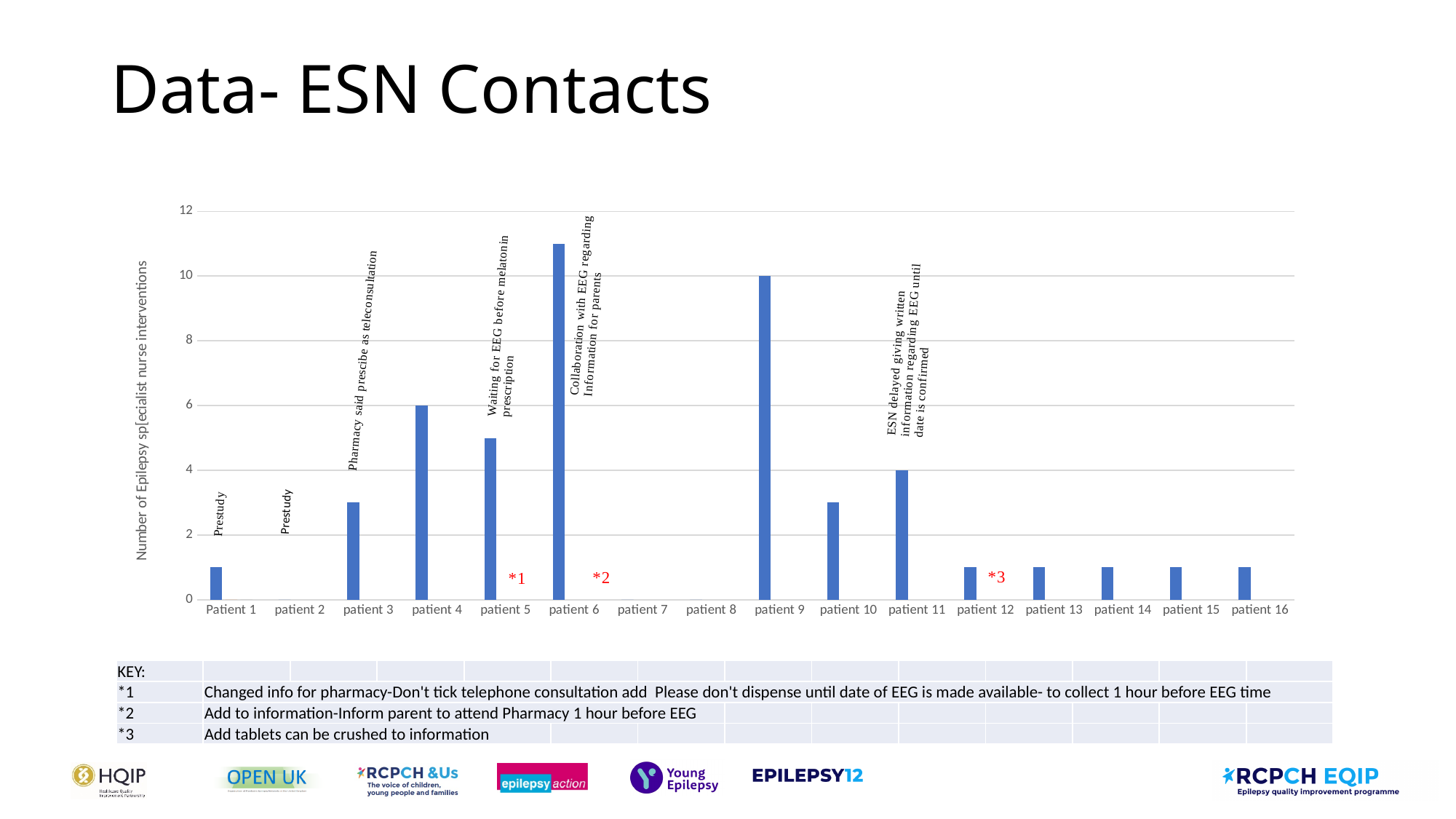
What kind of chart is shown on the slide? bar chart Which has more interventions, patient 9 or patient 4? patient 9 Is the value for patient 3 greater or less than 4? less Is the value for patient 6 greater or less than 10? greater What is the difference between the number of interventions for patient 9 and patient 11? 6 What is the label on the vertical axis of the chart? Number of Epilepsy sp[ecialist nurse interventions What is the number of interventions for patient 9? 10 Which patient has the highest number of epilepsy specialist nurse interventions? patient 6 How many patients are shown along the x axis of the chart? 16 What is the number of interventions for patient 4? 6 What is the title of the slide's chart? Data- ESN Contacts What is the number of interventions for patient 11? 4